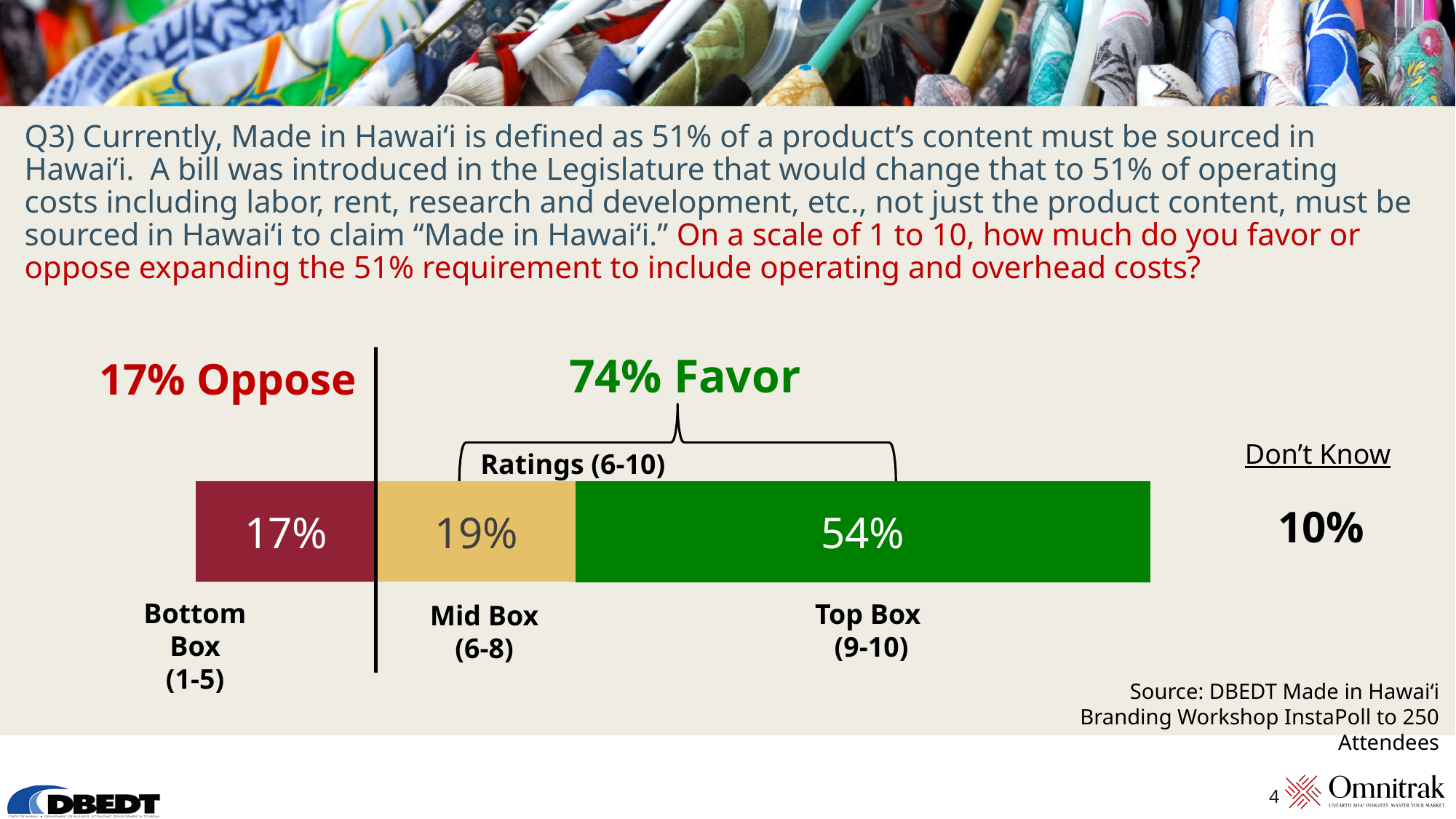
What percentage is shown for the Bottom Box (1-5) segment? 17% Which is larger, the Mid Box (6-8) value or the Bottom Box (1-5) value? Mid Box (6-8) What percentage of respondents answered Don't Know? 10% What total percentage is labelled as Oppose? 17% What kind of chart is shown on the slide? Stacked bar chart What is the difference between the Top Box (9-10) and Mid Box (6-8) percentages? 35% Which segment of the bar has the largest value? Top Box (9-10) How many segments make up the stacked bar? 3 Which segment of the bar has the smallest value? Bottom Box (1-5) What percentage is shown for the Mid Box (6-8) segment? 19% What total percentage is labelled as Favor? 74% What percentage is shown for the Top Box (9-10) segment? 54%